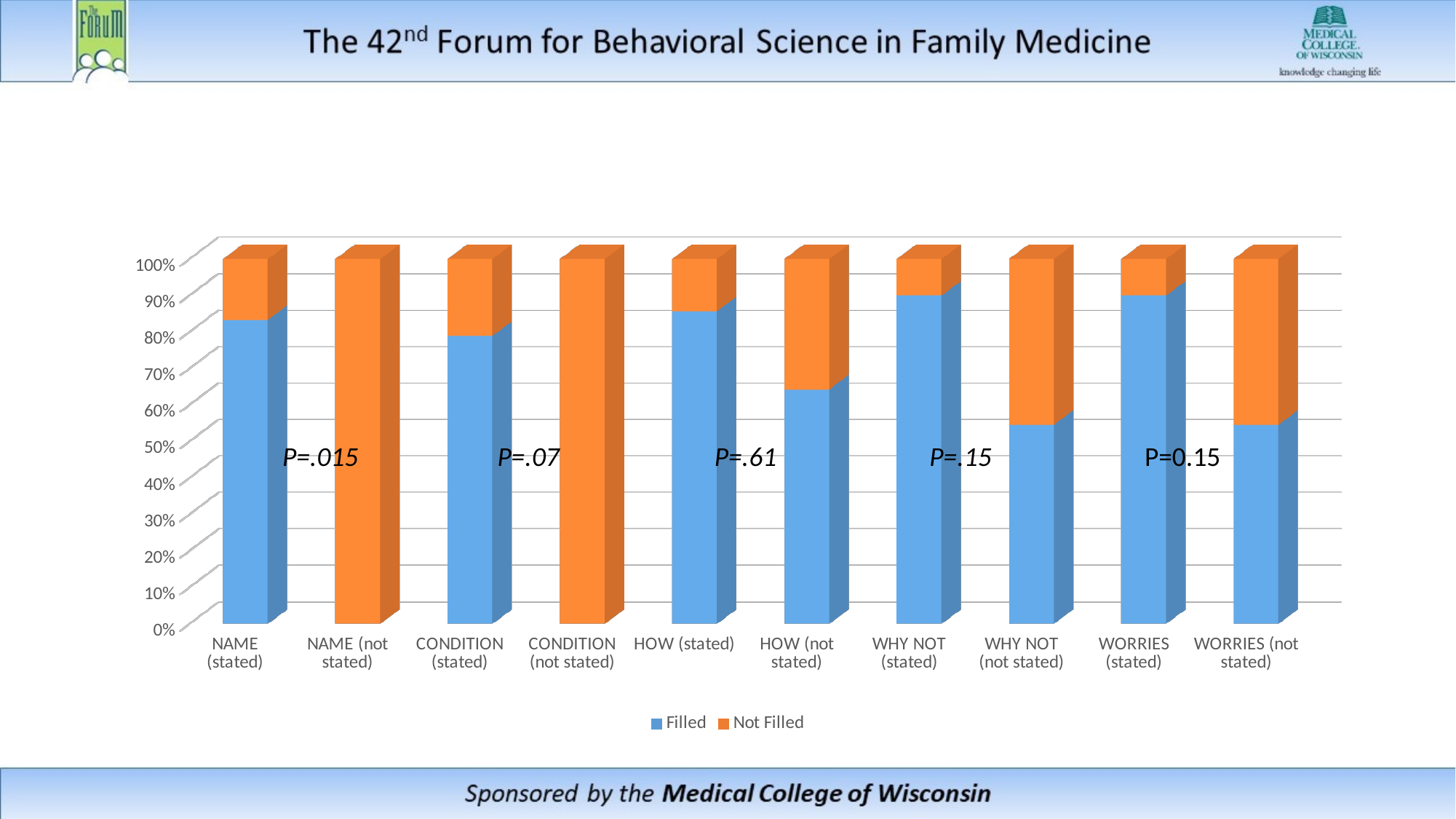
Which categories show no Filled portion at all (bars entirely Not Filled)? NAME (not stated) and CONDITION (not stated) What kind of chart is shown on the slide? Stacked bar chart How many categories are shown along the x axis of the chart? 10 How many series does the chart's legend list? 2 Is the Filled share for HOW (not stated) greater or less than 70%? less Which has the larger Filled share, HOW (stated) or HOW (not stated)? HOW (stated) Is the Filled share for WORRIES (stated) greater or less than 80%? greater Is the Filled share for NAME (stated) greater or less than 80%? greater Which has the larger Not Filled share, WHY NOT (stated) or WHY NOT (not stated)? WHY NOT (not stated) What are the two series named in the chart's legend? Filled and Not Filled What P value is printed above the NAME pair of bars? P=.015